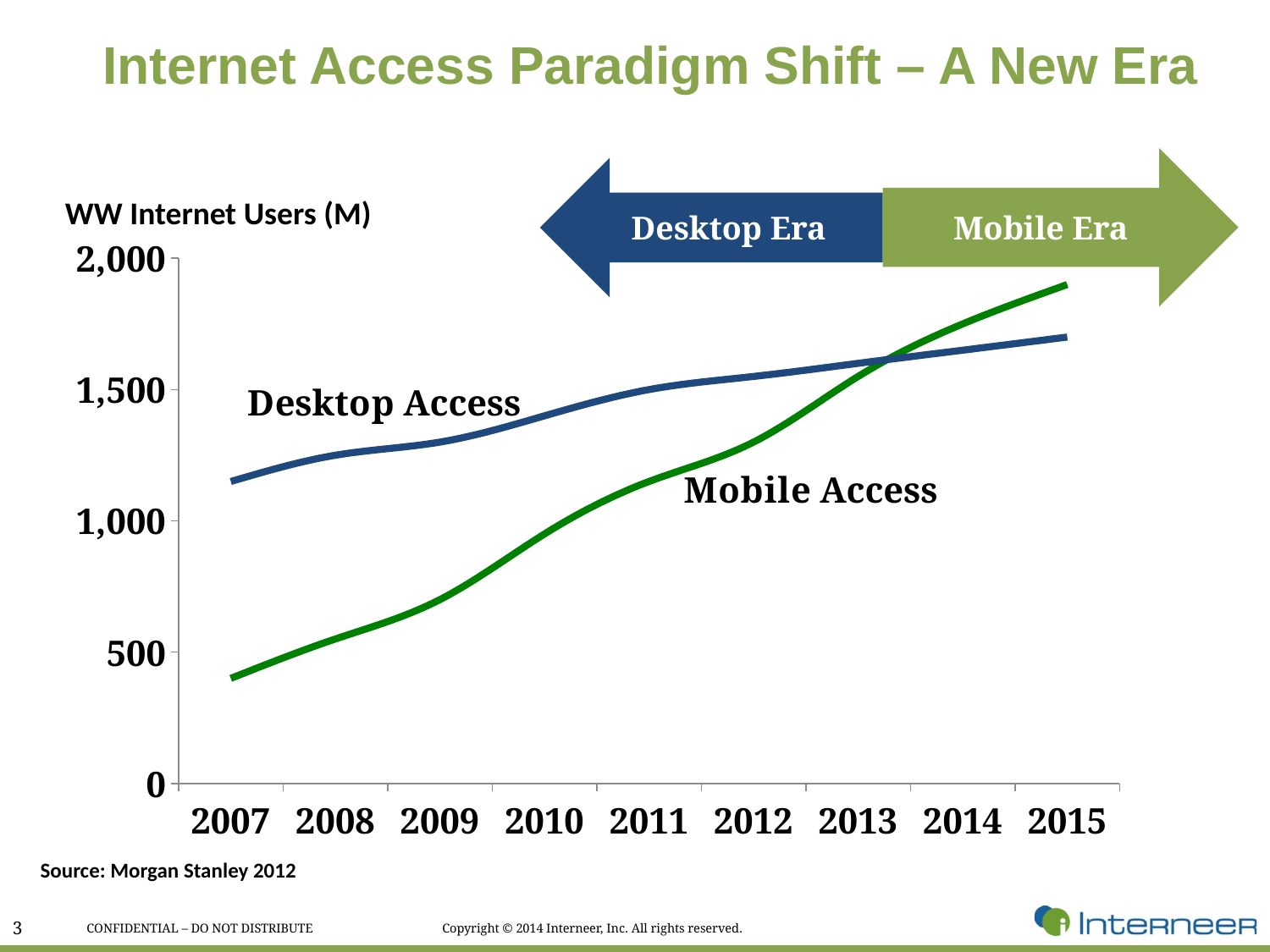
Is the value for Mobile Access in 2009 greater or less than 500? greater What kind of chart is shown on the slide? line chart In 2015, which series has the larger value, Desktop Access or Mobile Access? Mobile Access Is the value for Mobile Access in 2007 greater or less than 500? less Is the value for Mobile Access in 2015 greater or less than 1,500? greater In 2007, which series has the larger value, Desktop Access or Mobile Access? Desktop Access Does the Mobile Access line rise or fall from 2007 to 2015? rise How many years are shown along the x axis of the chart? 9 What is the label of the y axis of the chart? WW Internet Users (M) How many series are plotted on the chart? 2 Does the Desktop Access line rise or fall from 2007 to 2015? rise